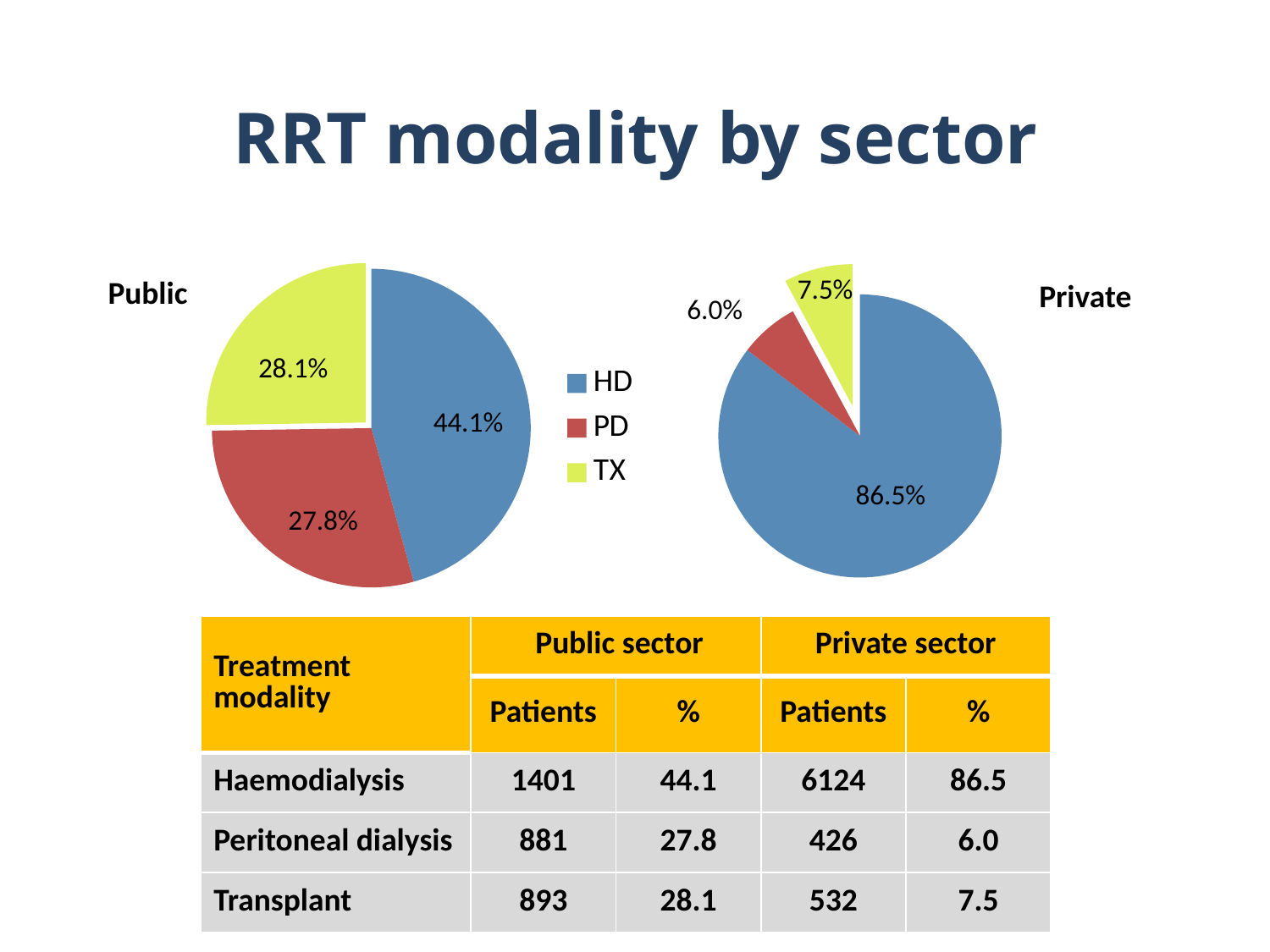
In the Public pie chart, which modality has the smallest slice? PD Which is larger: the TX share in the Public pie chart or the TX share in the Private pie chart? Public In the Private pie chart, what is the difference between the HD share and the TX share? 79.0% In the Public pie chart, what is the difference between the HD share and the PD share? 16.3% In the Private pie chart, what percentage is shown for TX? 7.5% In the Public pie chart, which modality has the largest slice? HD In the Public pie chart, what percentage is shown for HD? 44.1% In the Private pie chart, what percentage is shown for PD? 6.0% How many slices does the Private pie chart have? 3 How many entries does the legend list? 3 What type of chart is used to show the Public sector data? Pie chart In the Private pie chart, which modality has the smallest slice? PD